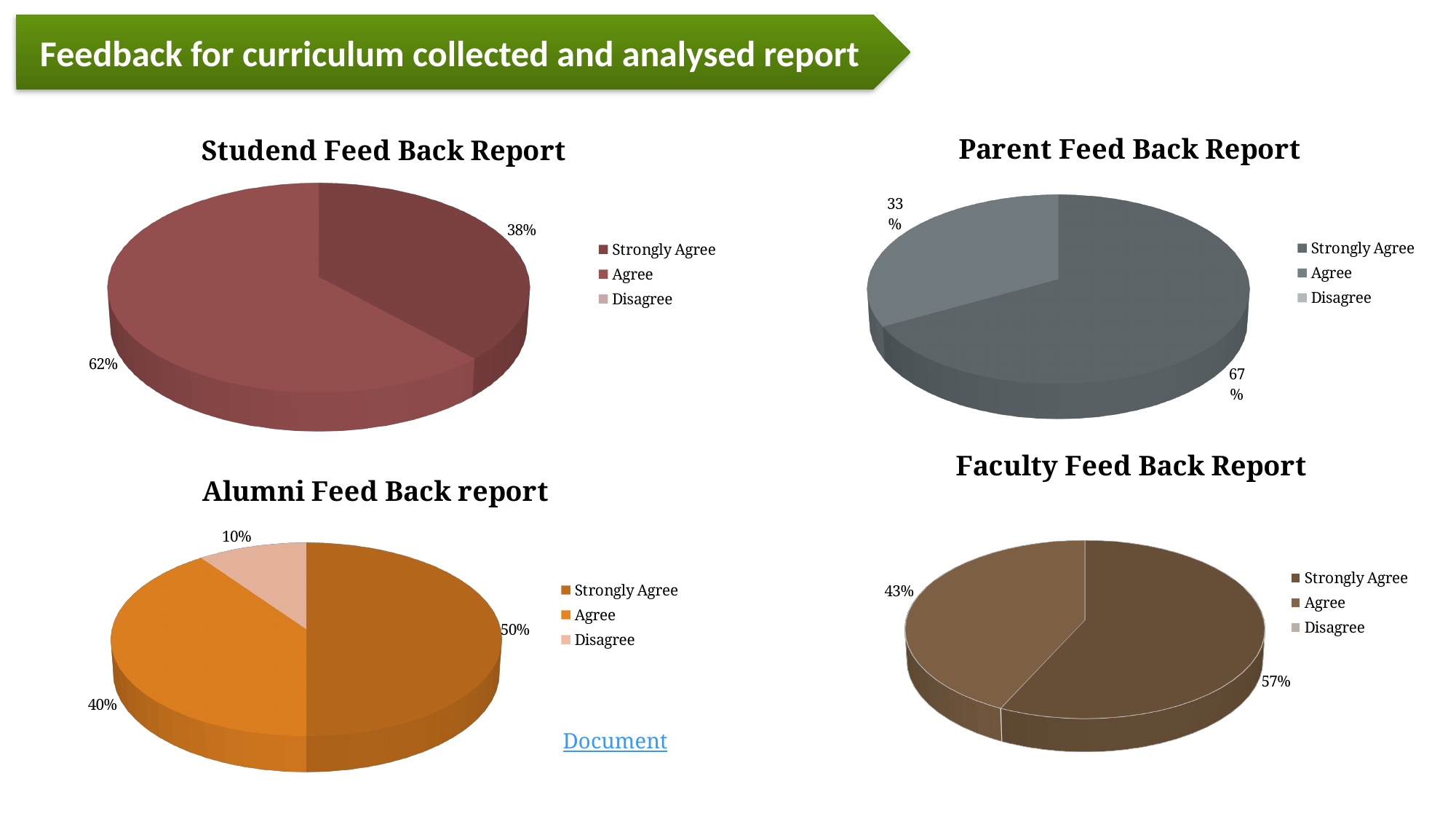
In the Alumni Feed Back report chart, which category has the smallest share? Disagree In the Faculty Feed Back Report chart, what percentage is shown for Agree? 43% In the Parent Feed Back Report chart, what percentage is shown for Strongly Agree? 67% How many entries does the legend of the Alumni Feed Back report chart list? 3 In the Faculty Feed Back Report chart, what is the difference between the Strongly Agree and Agree percentages? 14% In the Alumni Feed Back report chart, which category has the largest share? Strongly Agree In the Studend Feed Back Report chart, what percentage is shown for Strongly Agree? 38% In the Studend Feed Back Report chart, what percentage is shown for Agree? 62% In the Parent Feed Back Report chart, what percentage is shown for Agree? 33% In the Studend Feed Back Report chart, which is larger, Strongly Agree or Agree? Agree What kind of chart is the Parent Feed Back Report? Pie chart In the Alumni Feed Back report chart, what percentage is shown for Disagree? 10%